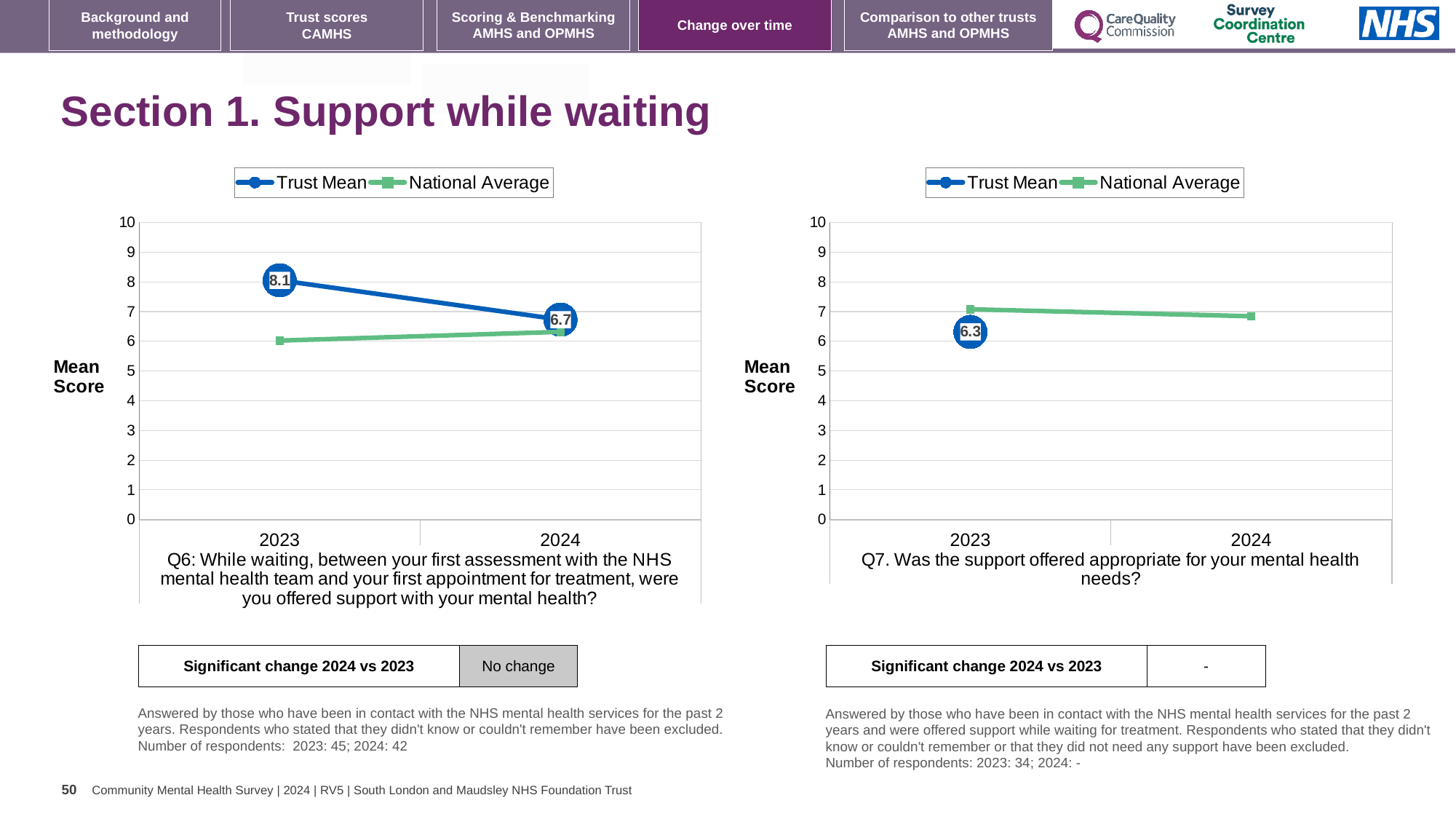
In the Q6 chart on the left, does the Trust Mean rise or fall from 2023 to 2024? fall In the Q6 chart on the left, which is larger in 2023: the Trust Mean or the National Average? Trust Mean How many series does the legend of the Q7 chart on the right list? 2 How many years are shown on the x axis of the Q6 chart on the left? 2 What kind of chart is the Q6 chart on the left? line chart In the Q6 chart on the left, by how much did the Trust Mean score fall from 2023 to 2024? 1.4 In the Q7 chart on the right, what is the Trust Mean score for 2023? 6.3 What is the label on the y axis of the Q7 chart on the right? Mean Score In the Q7 chart on the right, is the National Average for 2023 greater or less than 6? greater In the Q6 chart on the left, what is the Trust Mean score for 2024? 6.7 In the Q6 chart on the left, what is the Trust Mean score for 2023? 8.1 In the Q6 chart on the left, is the National Average for 2023 greater or less than 7? less